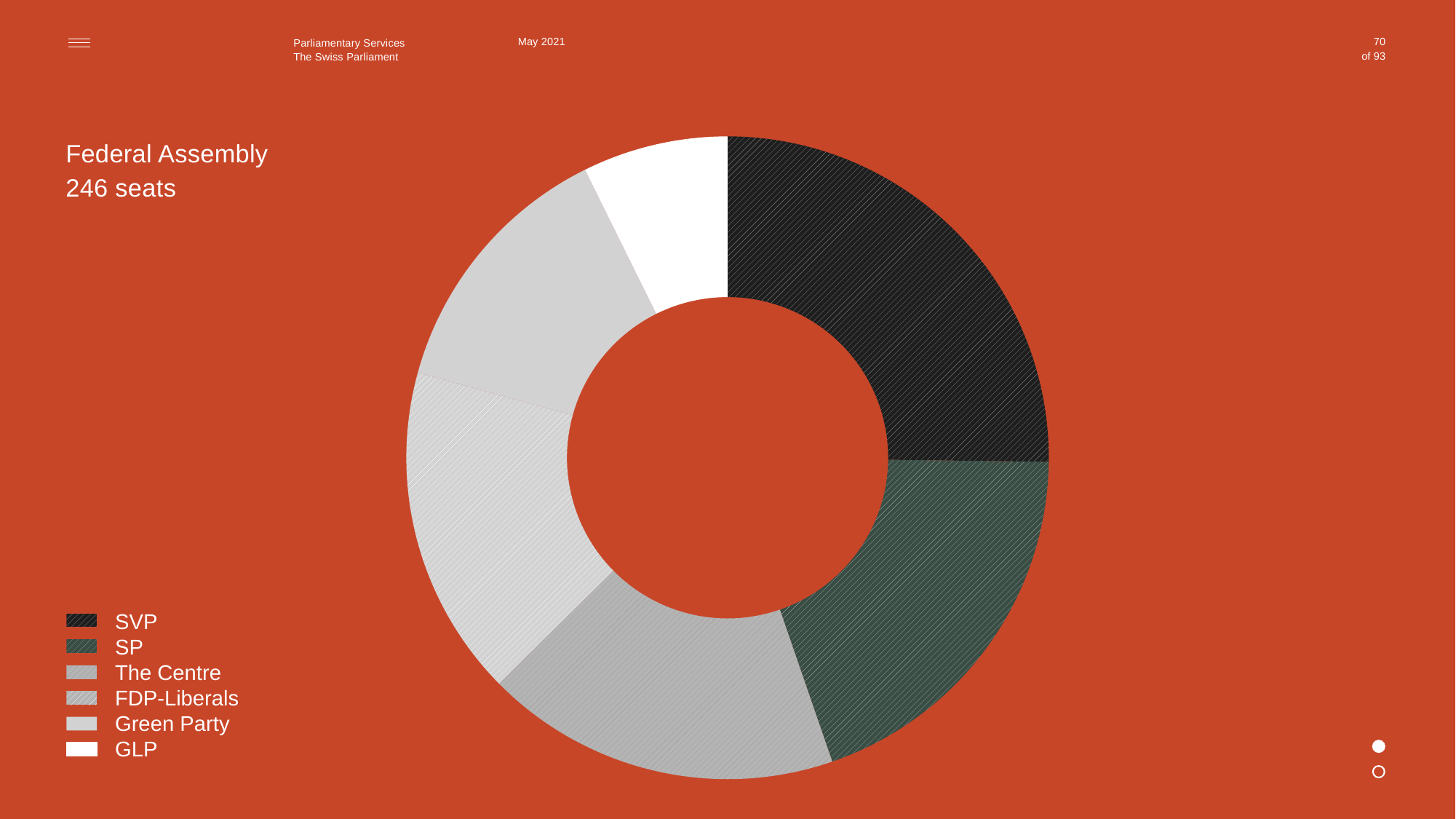
Which party is shown in white in the chart? GLP What kind of chart is shown on the slide? Pie chart (donut) How many slices does the donut chart have? 6 What is the title of the chart? Federal Assembly 246 seats Which slice is larger, FDP-Liberals or Green Party? FDP-Liberals Which slice is larger, SVP or Green Party? SVP Which slice is larger, SVP or SP? SVP Which party has the largest slice of the chart? SVP Which party has the smallest slice of the chart? GLP How many parties does the legend of the chart list? 6